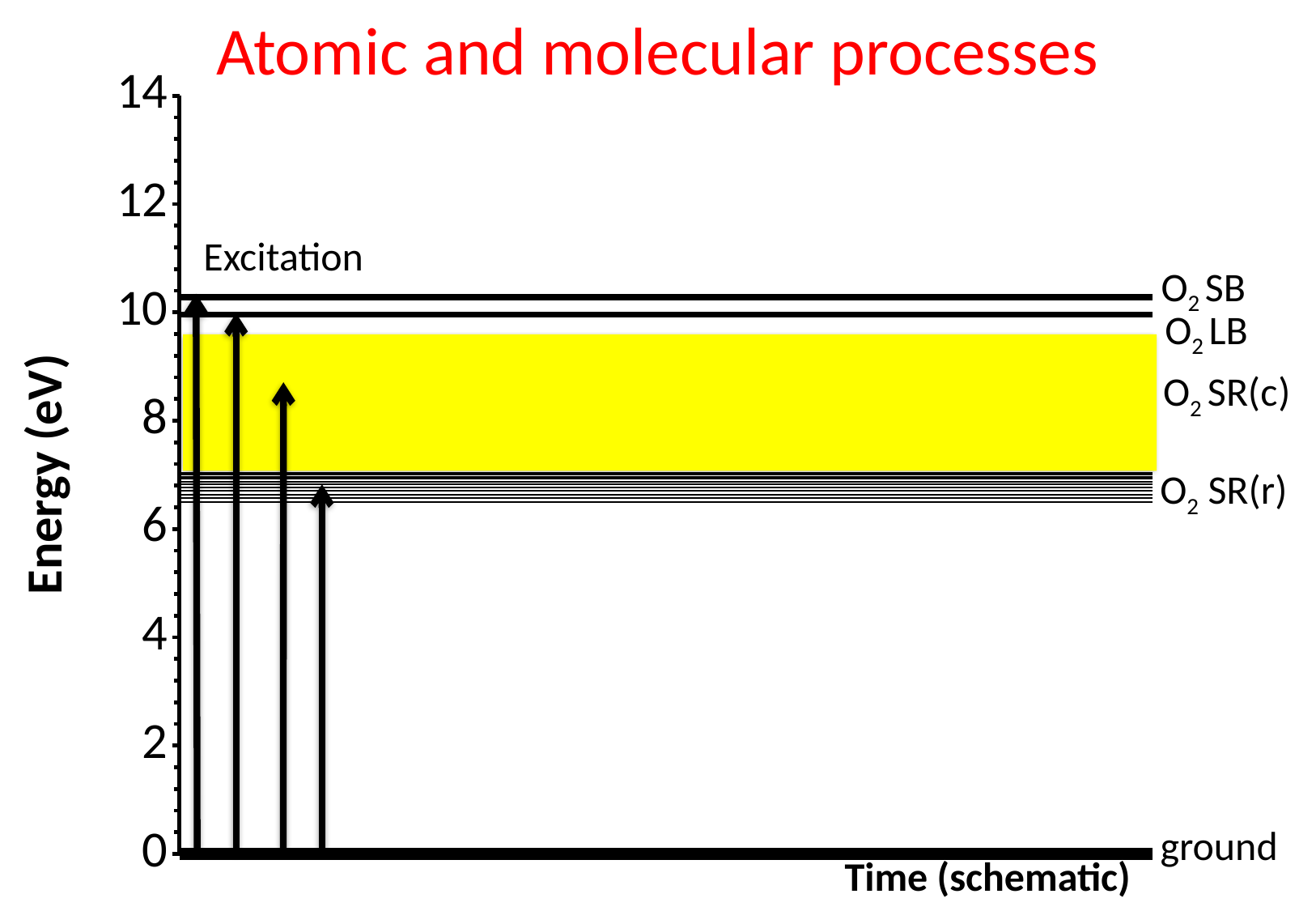
What kind of chart is shown on the slide? Energy level diagram What is the highest value shown on the energy axis? 14 Which labelled energy level is the highest on the diagram? O2 SB Is the energy of the O2 SR(r) levels greater or less than 6 eV? greater Which level lies at a higher energy, O2 SB or O2 SR(r)? O2 SB What is the label of the vertical axis? Energy (eV) Which labelled energy level is the lowest on the diagram? ground What is the title of the chart? Atomic and molecular processes Is the energy of the O2 SR(r) levels greater or less than 8 eV? less How many upward excitation arrows are drawn from the ground level? 4 Is the top of the O2 SR(c) band greater or less than 10 eV? less How many labelled energy levels (including ground) are shown on the right side of the diagram? 5